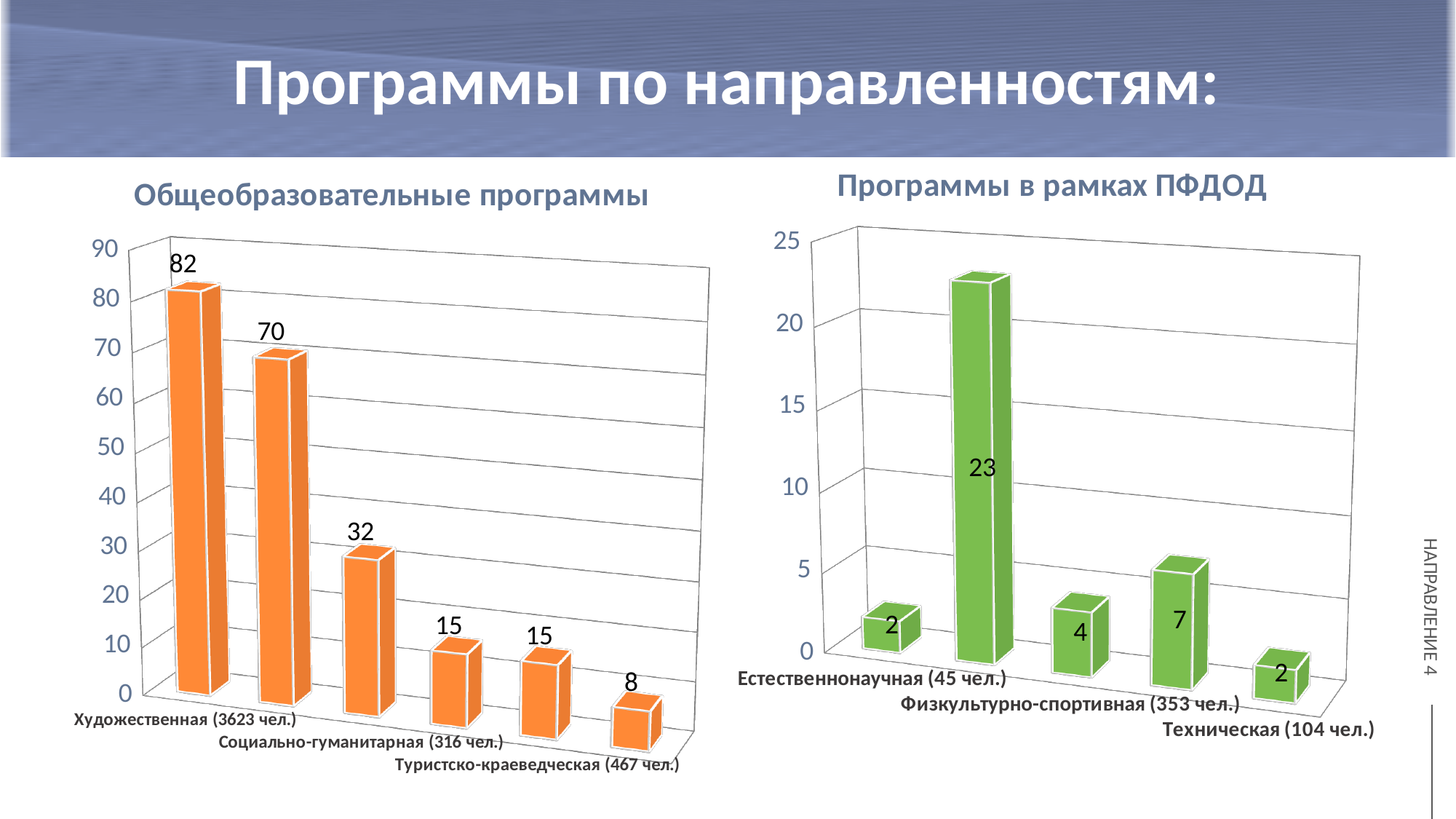
In the 'Программы в рамках ПФДОД' chart, what is the value for Естественнонаучная (45 чел.)? 2 How many bars are plotted in the 'Программы в рамках ПФДОД' chart? 5 What is the highest value shown in the 'Общеобразовательные программы' chart? 82 In the 'Общеобразовательные программы' chart, what is the difference between the two tallest bars (82 and 70)? 12 In the 'Общеобразовательные программы' chart, what is the value for Художественная (3623 чел.)? 82 Do the values in the 'Общеобразовательные программы' chart generally rise or fall from left to right? Fall How many bars are plotted in the 'Общеобразовательные программы' chart? 6 What type of chart is 'Общеобразовательные программы'? Bar chart In the 'Программы в рамках ПФДОД' chart, is the tallest bar greater or less than 20? greater What colour are the bars in the 'Программы в рамках ПФДОД' chart? Green What is the lowest value shown in the 'Общеобразовательные программы' chart? 8 What is the highest value shown in the 'Программы в рамках ПФДОД' chart? 23